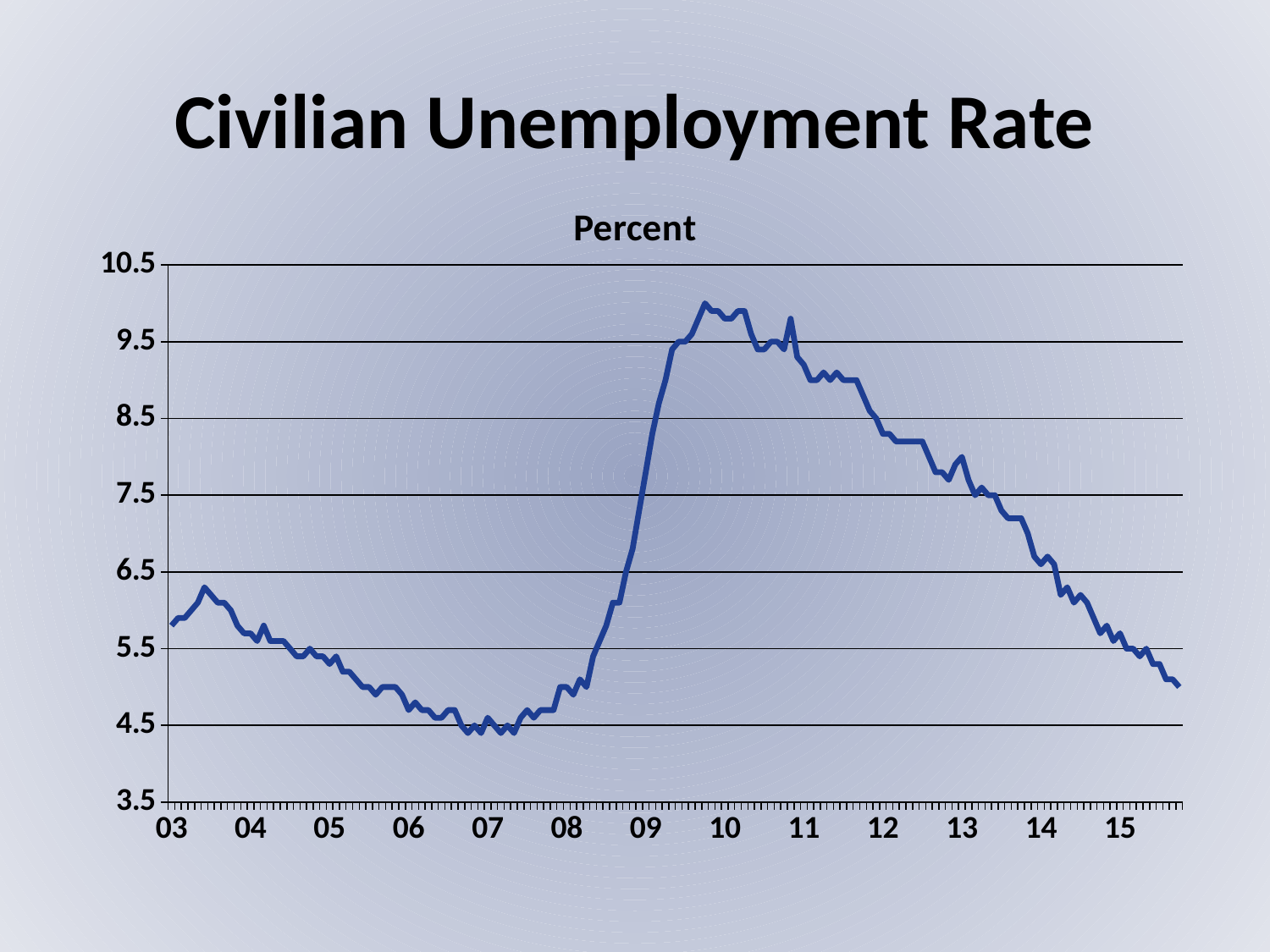
Is the value at the end of 15 greater or less than 5.5? less Is the value at the start of 03 greater or less than 5.5? greater What unit label is shown above the chart's plot area? Percent Which is larger, the value at the 10 tick or the value at the 13 tick? 10 Does the unemployment rate rise or fall between 08 and 09? rise What kind of chart is shown on the slide? line chart Does the unemployment rate rise or fall between 03 and 07? fall What is the title of the chart? Percent How many year labels are shown along the x axis? 13 Is the value at the 13 tick greater or less than 7.5? greater